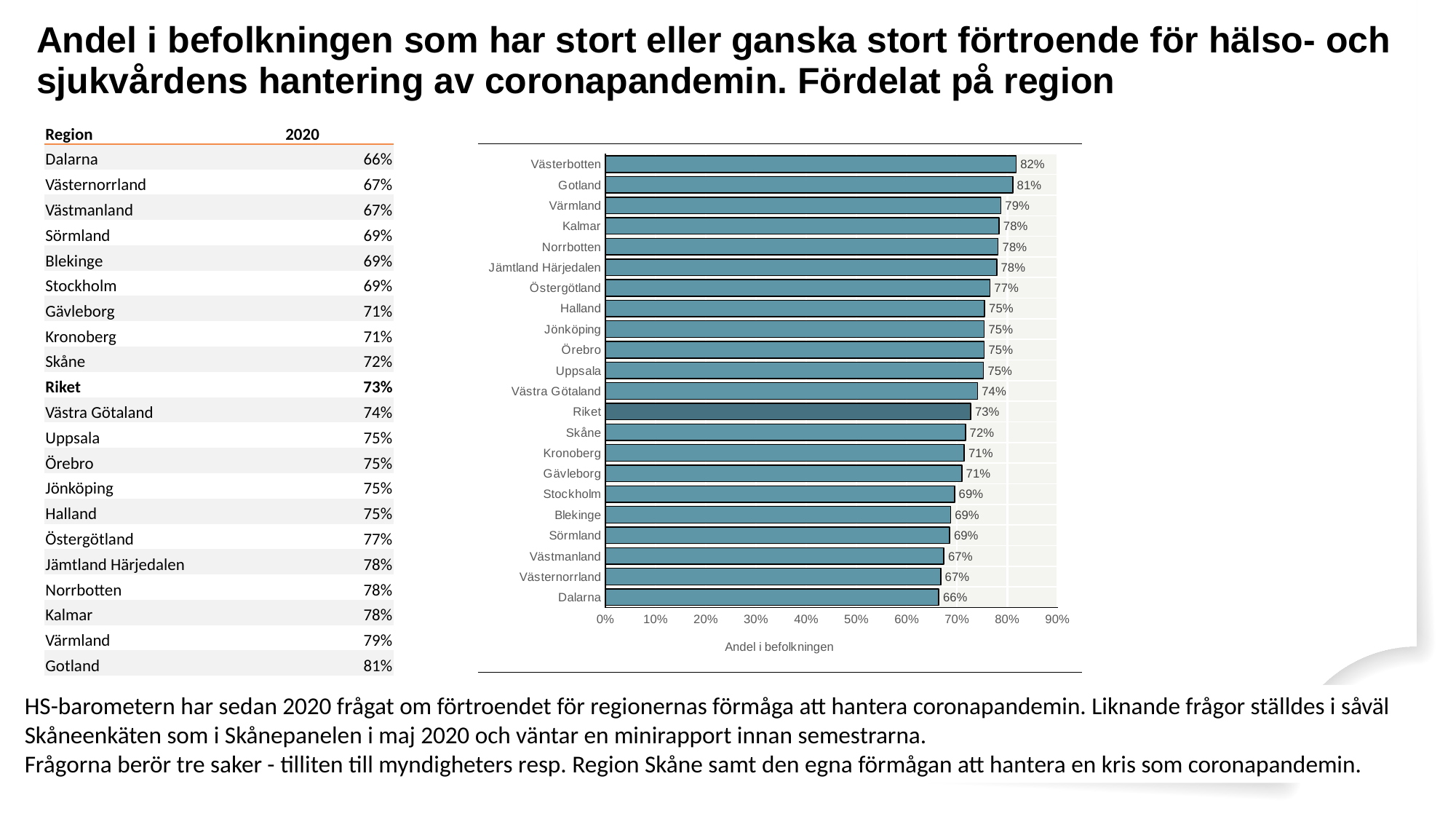
Which has a larger value, Värmland or Skåne? Värmland What is the value for Riket in the chart? 73% What is the difference between the values for Gotland and Riket? 8% What is the value for Östergötland in the chart? 77% Which region has the highest value in the chart? Västerbotten How many bars are shown in the chart? 22 Which region has the lowest value in the chart? Dalarna Is the value for Stockholm greater or less than 70%? less What is the difference between the values for Västerbotten and Dalarna? 16% What kind of chart is shown on the slide? bar chart What is the label of the horizontal axis of the chart? Andel i befolkningen What is the value for Västerbotten in the chart? 82%